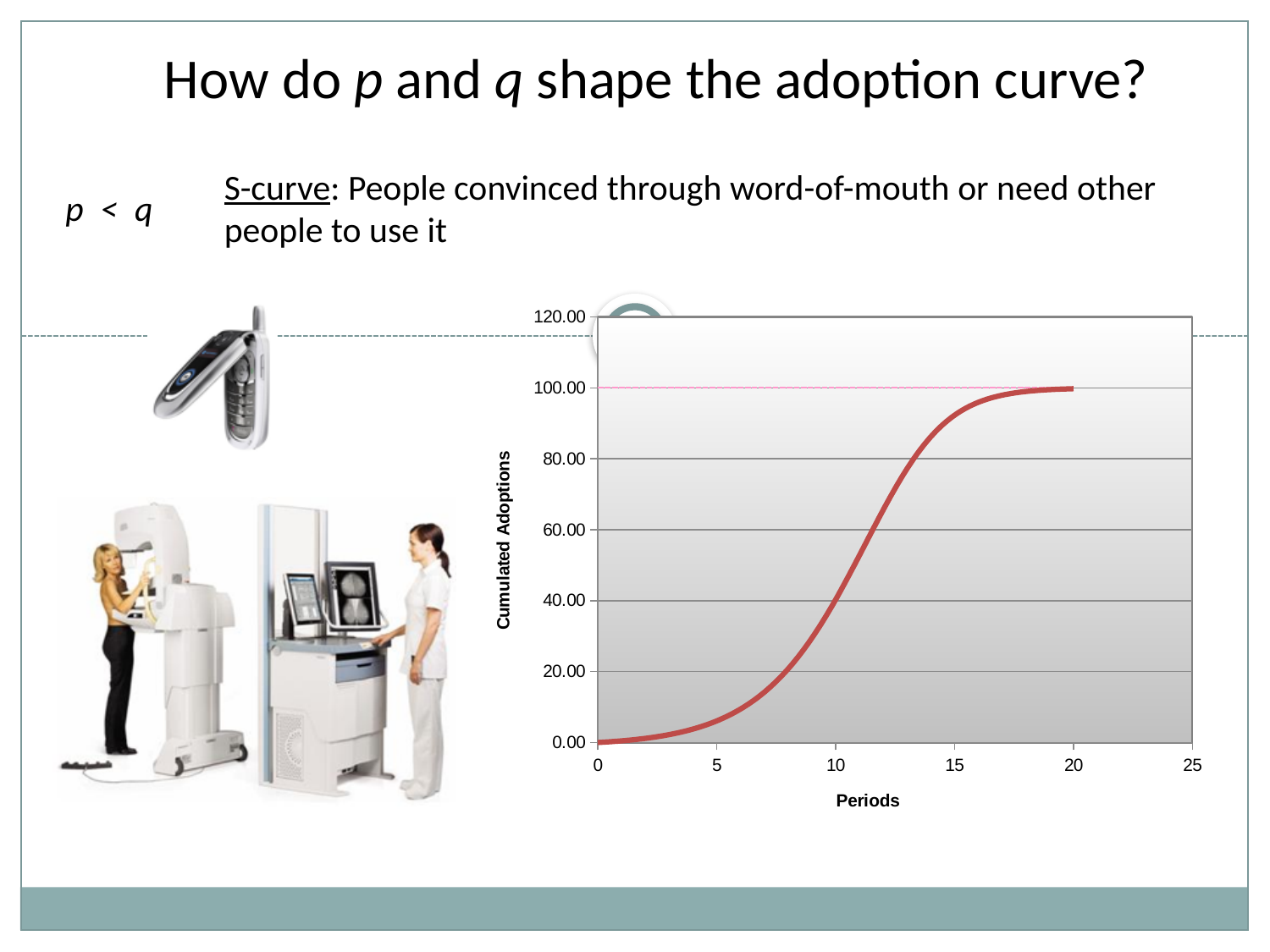
What is the label of the y axis of the chart? Cumulated Adoptions At which period is the red curve at its lowest value? 0 Is the value of the red curve at period 5 greater or less than 20.00? less Is the value of the red curve at period 8 greater or less than 40.00? less Is the value of the red curve at period 15 greater or less than 80.00? greater What is the label of the x axis of the chart? Periods Do the values of the red curve rise or fall as the periods increase? rise What is the highest tick value shown on the y axis of the chart? 120.00 At which period does the red curve reach its highest value? 20 What kind of chart is shown on the slide? line chart